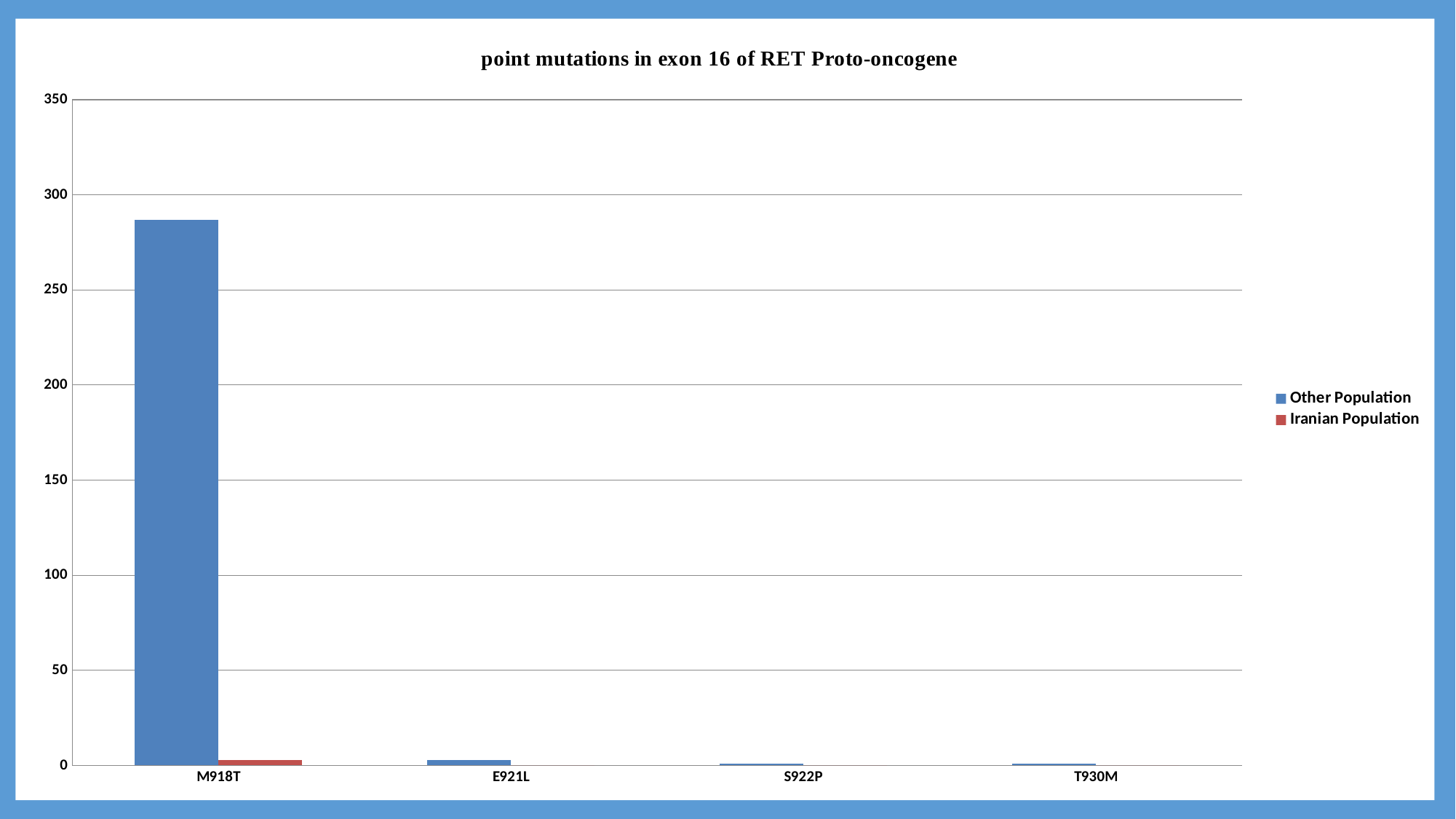
Is the Other Population value for M918T greater or less than 250? greater Is the Other Population value for M918T greater or less than 300? less Do the Other Population values rise or fall from M918T to E921L? fall Which mutation has the highest value for Other Population? M918T What is the title of the chart? point mutations in exon 16 of RET Proto-oncogene Which series is shown in red in the legend? Iranian Population How many series does the legend list? 2 For M918T, which is larger: the Other Population value or the Iranian Population value? Other Population How many mutation categories are shown on the x axis? 4 Is the Other Population value for E921L greater or less than 50? less What kind of chart is shown on the slide? bar chart Which is larger: the Other Population value for M918T or the Other Population value for E921L? M918T